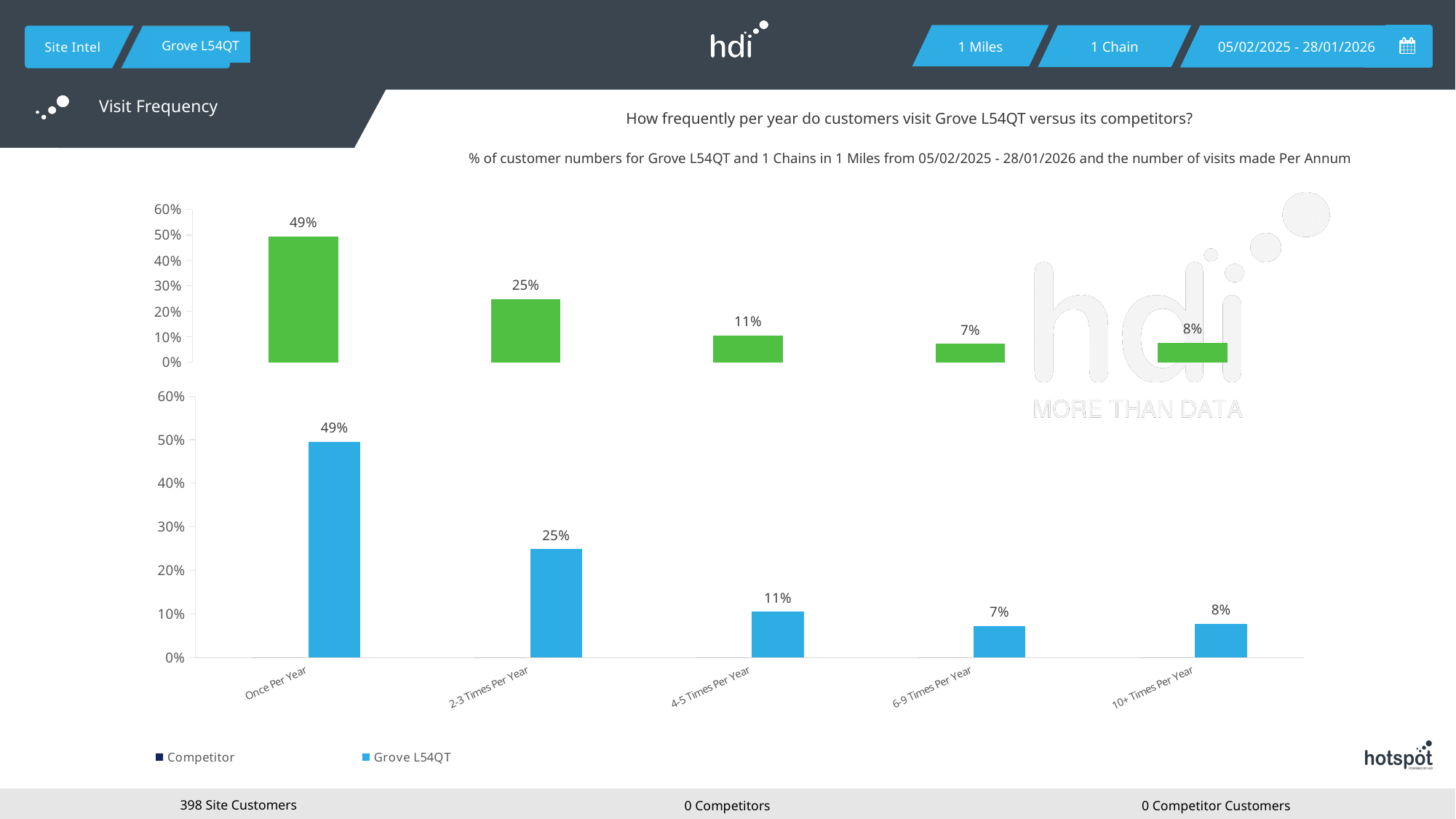
What kind of chart is the bottom chart? Bar chart How many series does the legend below the bottom chart list? 2 In the bottom chart, what is the value for 4-5 Times Per Year? 11% In the bottom chart, which is larger: the value for 6-9 Times Per Year or 10+ Times Per Year? 10+ Times Per Year In the bottom chart, which category has the highest value? Once Per Year In the bottom chart, which category has the lowest value? 6-9 Times Per Year In the bottom chart, what is the value for Once Per Year? 49% In the bottom chart, what is the value for 2-3 Times Per Year? 25% In the bottom chart, what is the difference between the values for Once Per Year and 2-3 Times Per Year? 24% In the top chart, what is the value shown on the first (leftmost) bar? 49% How many categories are shown on the x axis of the bottom chart? 5 In the bottom chart, what is the value for 10+ Times Per Year? 8%